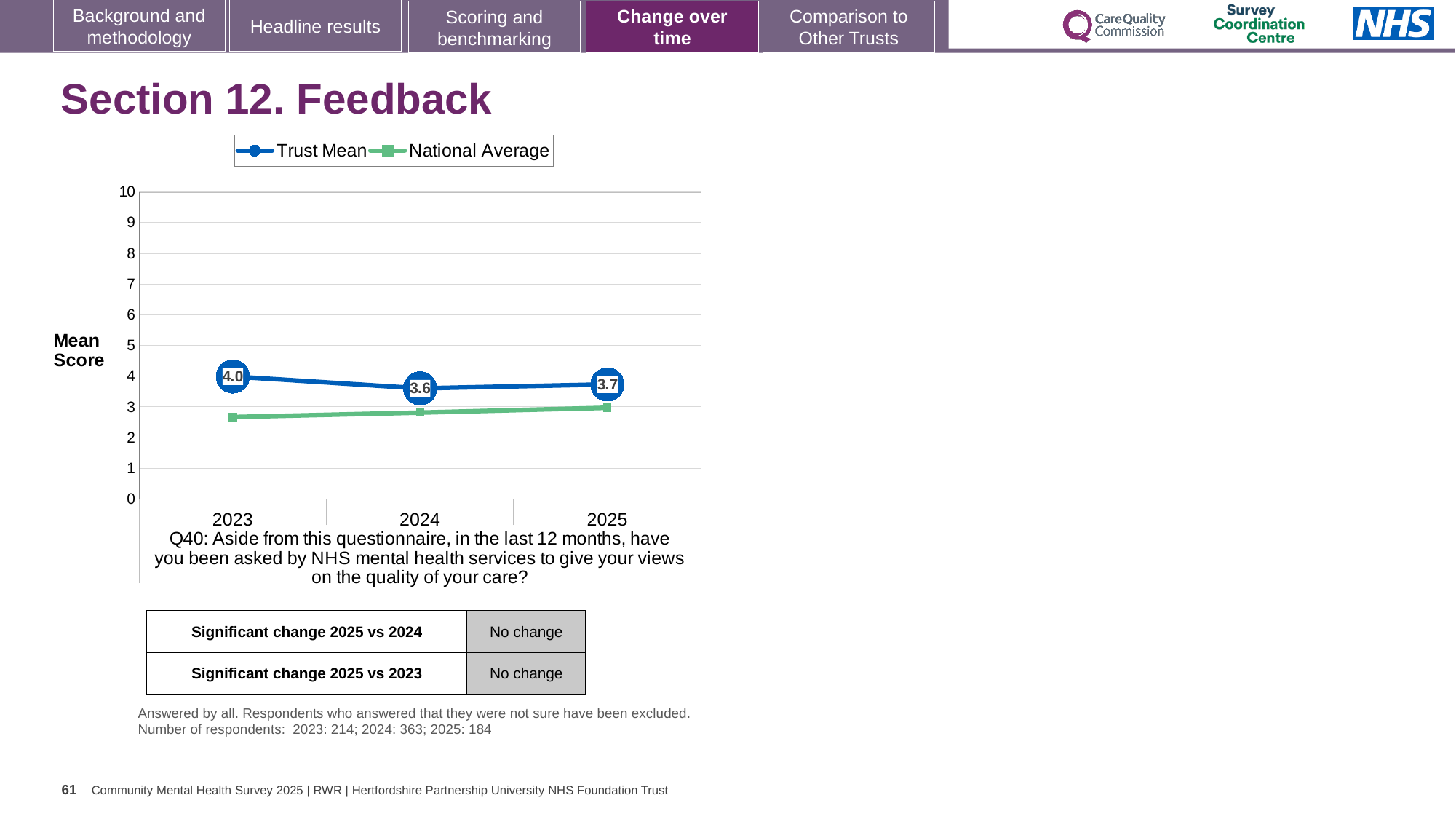
In which year is the Trust Mean lowest? 2024 What kind of chart is shown on the slide? line chart How many years are shown on the x axis? 3 What is the Trust Mean score for 2023? 4.0 What is the difference between the Trust Mean in 2023 and in 2024? 0.4 Which is larger, the Trust Mean in 2023 or in 2025? 2023 What is the Trust Mean score for 2025? 3.7 Does the National Average rise or fall from 2023 to 2025? rise How many series does the legend list? 2 What is the Trust Mean score for 2024? 3.6 Is the National Average value for 2023 greater or less than 3? less In which year is the Trust Mean highest? 2023